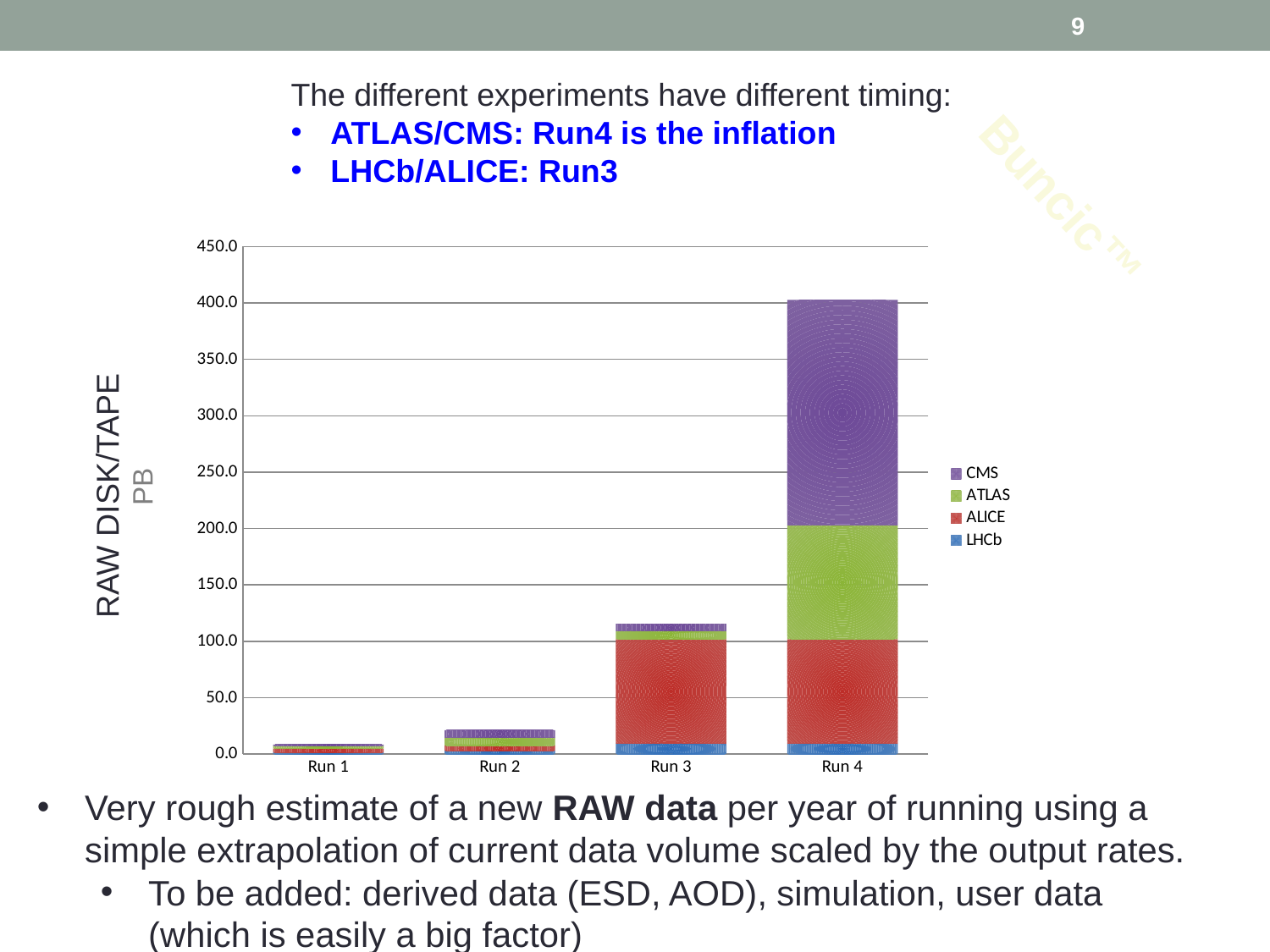
Do the total bar values rise or fall from Run 1 to Run 4? rise How many categories (runs) are shown on the x axis of the chart? 4 What is the label on the chart's vertical axis? RAW DISK/TAPE PB What kind of chart is shown on the slide? Stacked bar chart Which run has the lowest total stacked bar? Run 1 Which run has the highest total stacked bar? Run 4 How many series does the chart's legend list? 4 Is the total value for Run 3 greater or less than 100.0? greater Which series contributes the largest segment to the Run 4 bar? CMS Which is larger, the total bar for Run 3 or the total bar for Run 2? Run 3 Is the total value for Run 2 greater or less than 50.0? less Is the total value for Run 4 greater or less than 350.0? greater